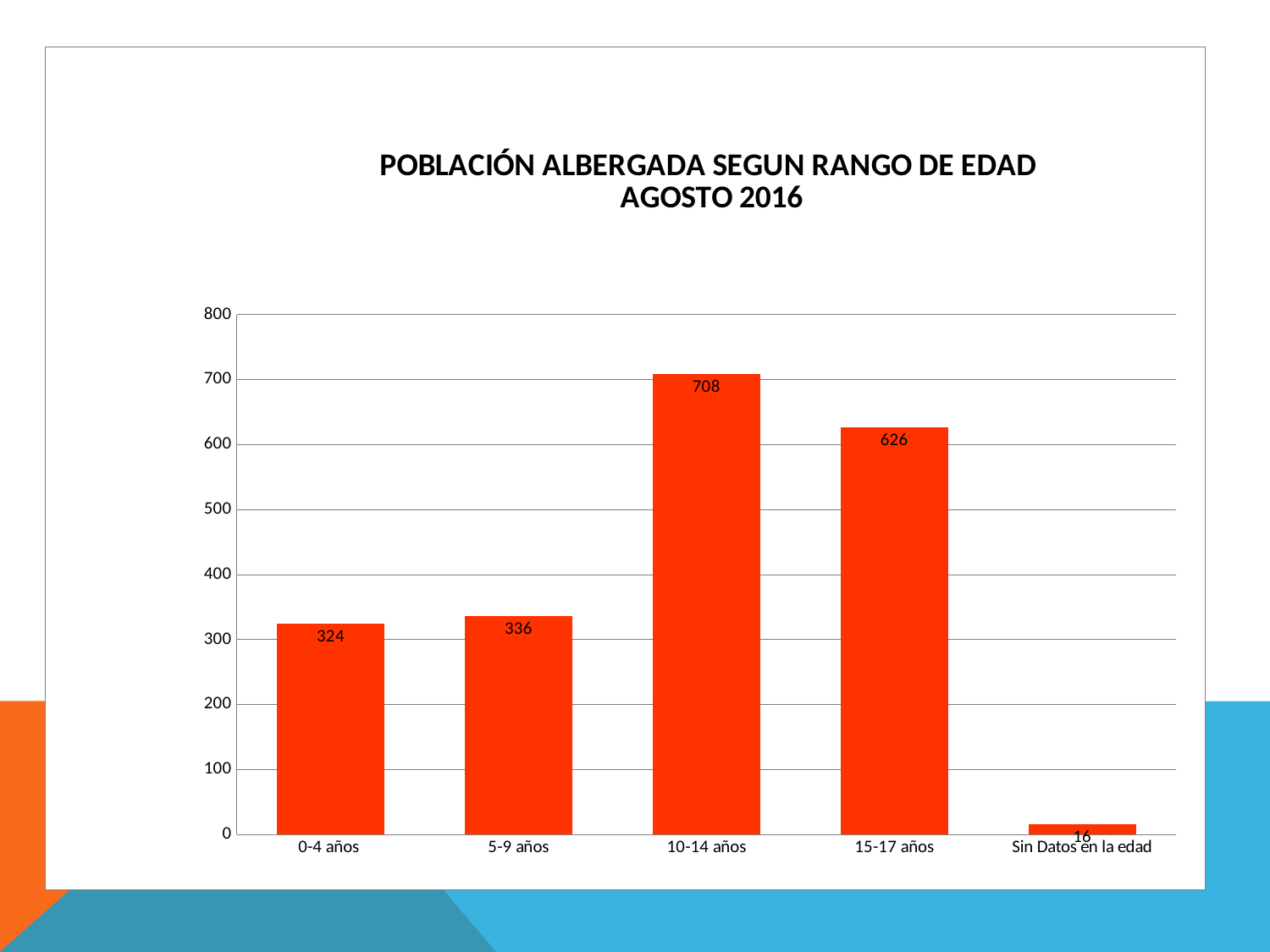
Is the value for 15-17 años greater or less than 600? greater What is the value for 0-4 años? 324 What kind of chart is this? bar chart Which category has the lowest value? Sin Datos en la edad Which age range has the highest value? 10-14 años What is the value for 10-14 años? 708 How many categories are shown on the x axis? 5 Which is larger, the value for 15-17 años or the value for 5-9 años? 15-17 años What is the difference between the values for 10-14 años and 15-17 años? 82 What is the title of the chart? POBLACIÓN ALBERGADA SEGUN RANGO DE EDAD AGOSTO 2016 What is the difference between the values for 5-9 años and 0-4 años? 12 What is the value for Sin Datos en la edad? 16